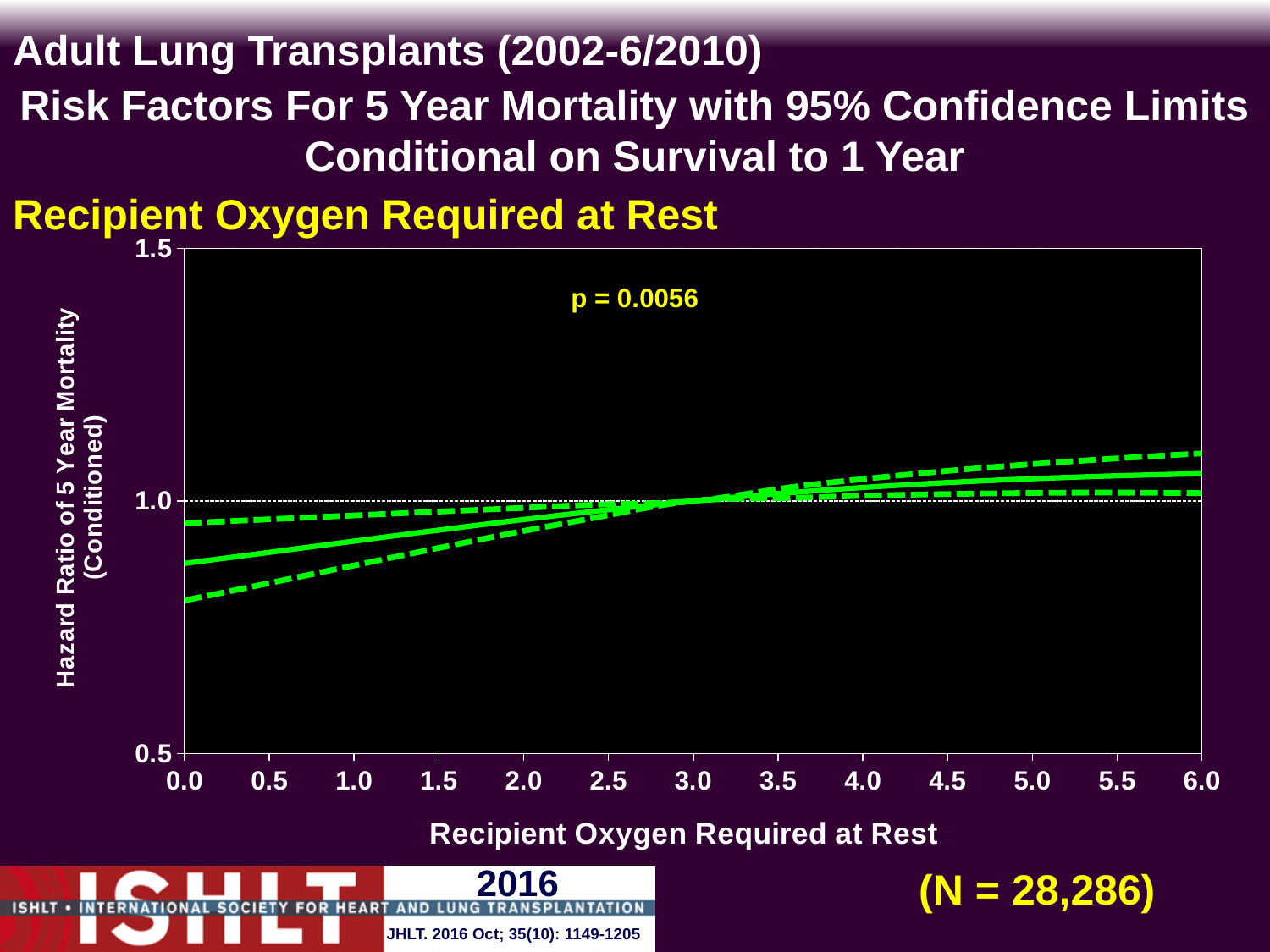
What is the highest value labelled on the x axis of the chart? 6.0 What p-value is printed on the chart? p = 0.0056 What is the minimum value shown on the y axis of the chart? 0.5 How many green lines (hazard ratio plus confidence limits) are plotted on the chart? 3 Is the hazard ratio (solid line) at a Recipient Oxygen Required at Rest of 6.0 greater or less than 1.0? greater Does the hazard ratio (solid line) rise or fall as Recipient Oxygen Required at Rest increases from 0.0 to 6.0? rise Is the lower 95% confidence limit (lower dashed line) at a Recipient Oxygen Required at Rest of 0.0 greater or less than 1.0? less Is the hazard ratio (solid line) at a Recipient Oxygen Required at Rest of 0.0 greater or less than 1.0? less What kind of chart is shown on the slide? line chart